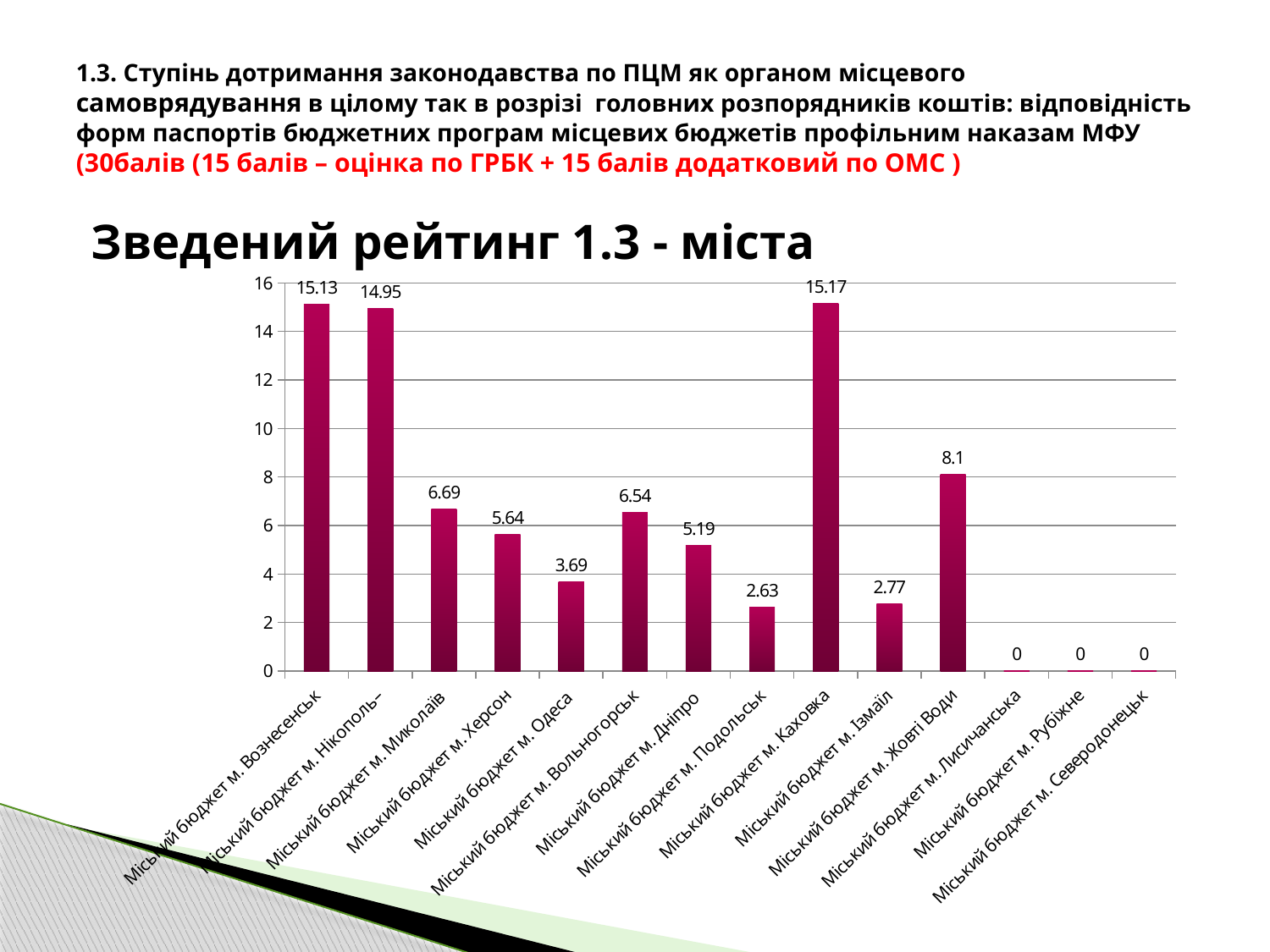
What is the value for Міський бюджет м. Одеса? 3.69 What is the difference between the values for Міський бюджет м. Вознесенськ and Міський бюджет м. Нікополь? 0.18 Is the value for Міський бюджет м. Миколаїв greater or less than 6? greater What type of chart is shown on the slide? Bar chart What is the value for Міський бюджет м. Каховка? 15.17 Which is larger, the value for Міський бюджет м. Херсон or Міський бюджет м. Дніпро? Міський бюджет м. Херсон How many cities have a value of 0? 3 What is the value for Міський бюджет м. Жовті Води? 8.1 What is the value for Міський бюджет м. Подольськ? 2.63 How many cities are shown in the chart? 14 What is the difference between the values for Міський бюджет м. Жовті Води and Міський бюджет м. Ізмаїл? 5.33 Which city has the highest value in the chart? Міський бюджет м. Каховка